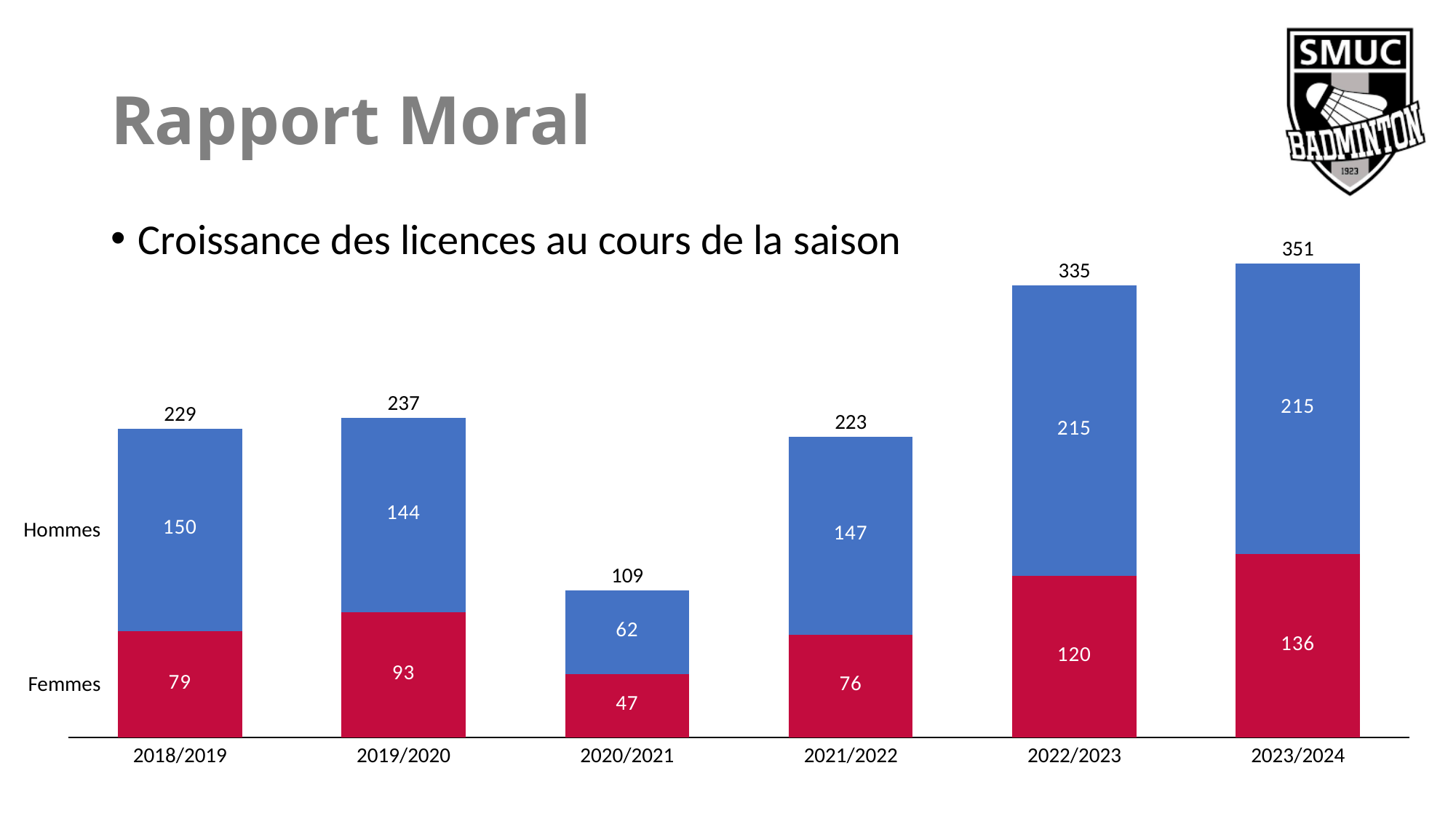
Which season has the highest total? 2023/2024 How many series are shown in the chart? 2 Which season has the lowest total? 2020/2021 Which colour represents the Femmes series? Red How many seasons are shown on the x axis? 6 What is the Femmes value for 2018/2019? 79 What is the total of the stacked bar for 2022/2023? 335 What is the difference between the Hommes value and the Femmes value in 2023/2024? 79 Which is larger, the Femmes value for 2019/2020 or the Femmes value for 2021/2022? 2019/2020 What kind of chart is shown? Stacked bar chart Do the totals rise or fall from 2020/2021 to 2023/2024? Rise What is the Hommes value for 2021/2022? 147